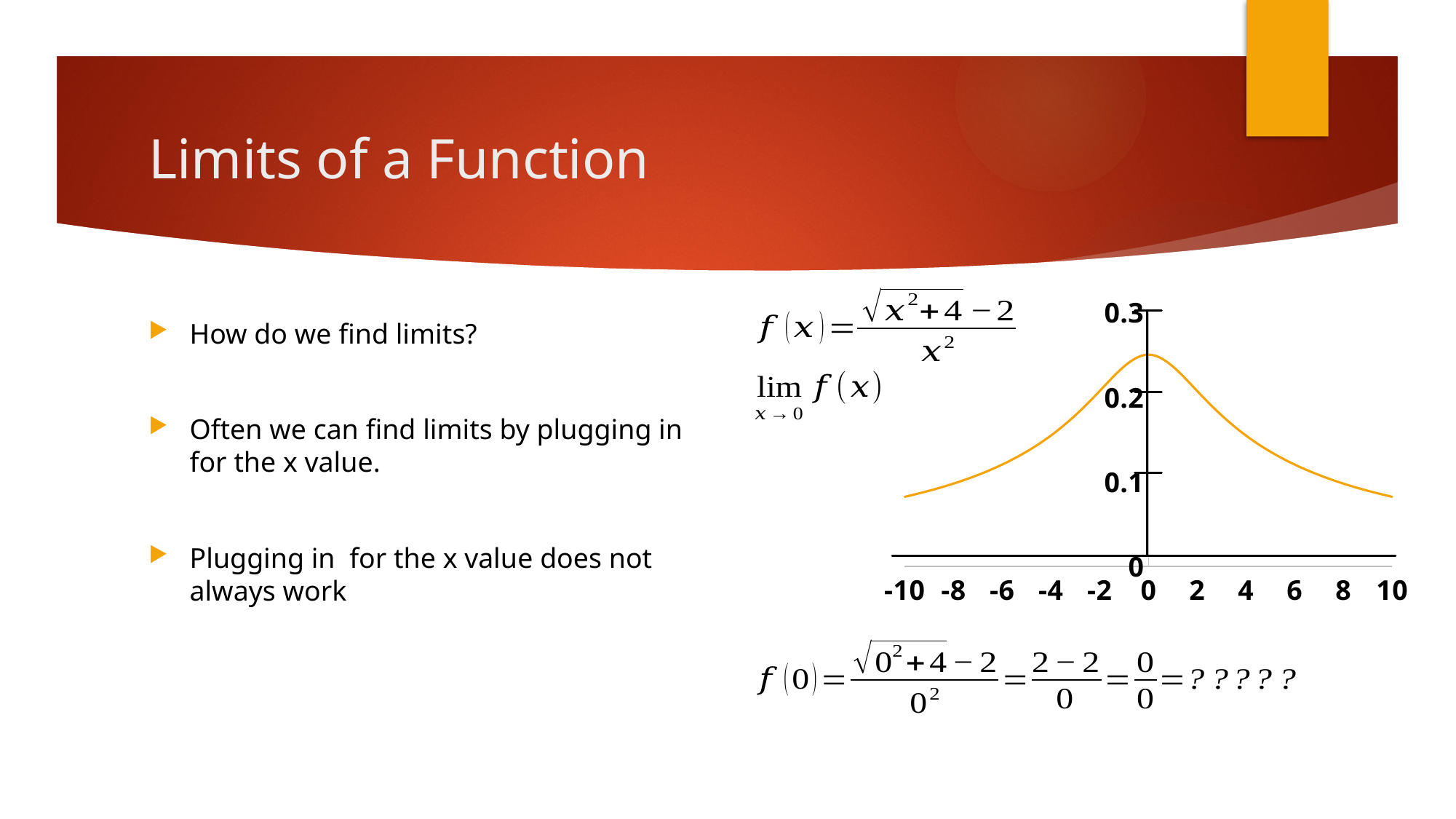
What is the highest value labelled on the y axis of the chart? 0.3 At which x value does the plotted curve reach its highest point? 0 Is the value of the curve at x = 0 greater or less than 0.3? less Does the curve rise or fall as x goes from 0 to 10? fall Is the value of the curve at x = -10 greater or less than 0.1? less What kind of chart is shown on the right of the slide? line chart What colour is the plotted curve on the chart? orange Is the value of the curve at x = 0 greater or less than 0.2? greater Which is larger, the value of the curve at x = 0 or at x = 10? x = 0 How many tick labels are shown on the x axis of the chart? 11 Does the curve rise or fall as x goes from -10 to 0? rise